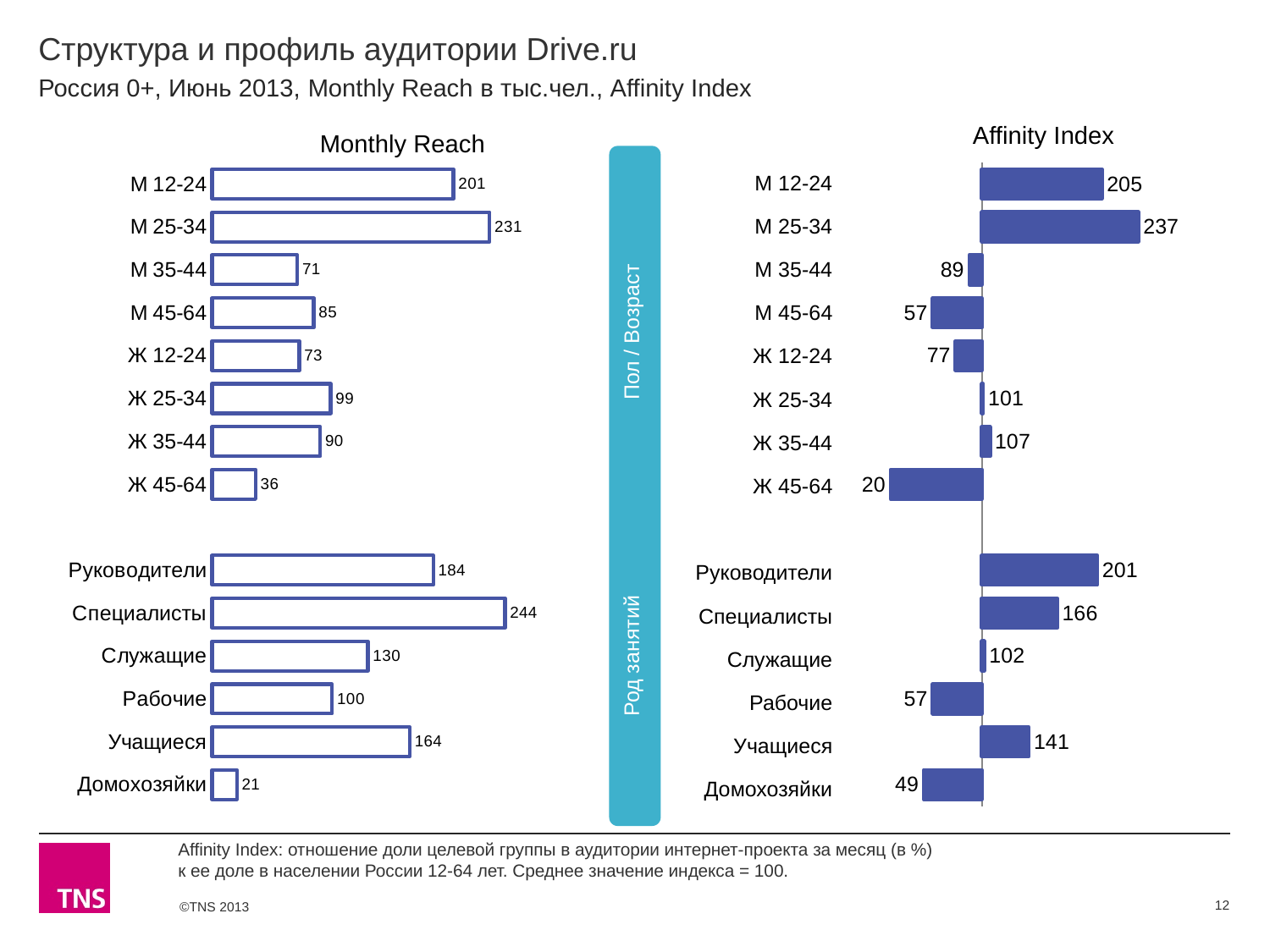
How many categories are shown in the Monthly Reach chart? 14 In the Monthly Reach chart, what is the value for Домохозяйки? 21 In the Monthly Reach chart, what is the value for М 25-34? 231 In the Affinity Index chart, what is the difference between Руководители and Специалисты? 35 In the Affinity Index chart, what is the value for Учащиеся? 141 In the Monthly Reach chart, what is the difference between Руководители and Учащиеся? 20 In the Affinity Index chart, which is larger: М 12-24 or М 25-34? М 25-34 In the Affinity Index chart, what is the value for Ж 45-64? 20 What type of chart is the Affinity Index chart? Bar chart In the Monthly Reach chart, which is larger: Ж 25-34 or Ж 35-44? Ж 25-34 In the Monthly Reach chart, which category has the highest value? Специалисты In the Affinity Index chart, which category has the lowest value? Ж 45-64